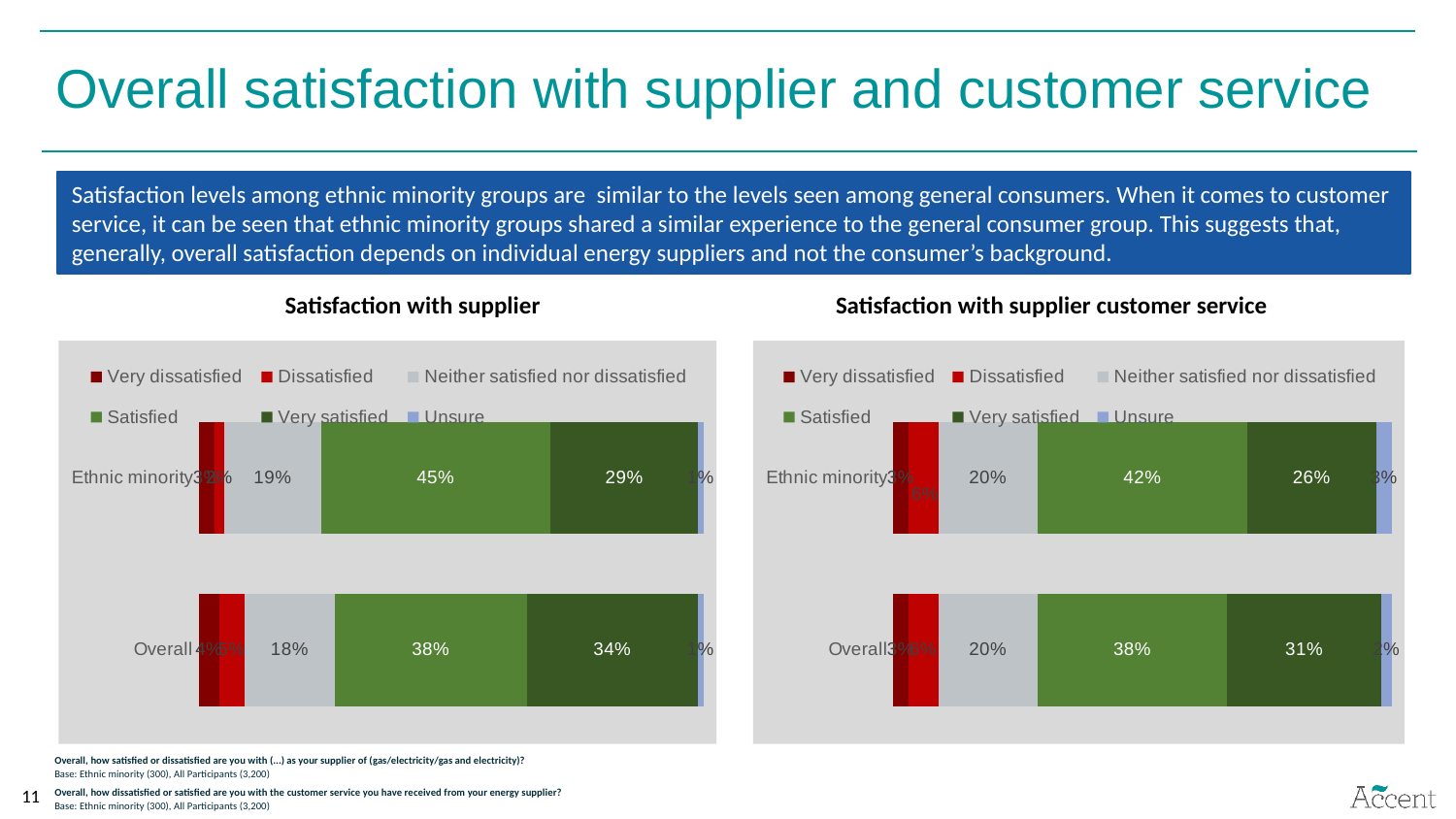
In the 'Satisfaction with supplier customer service' chart, what percentage of the Overall group is Very satisfied? 31% In the 'Satisfaction with supplier' chart, what is the difference between the Satisfied percentages for Ethnic minority and Overall? 7% What type of chart is the 'Satisfaction with supplier' chart? Stacked bar chart In the 'Satisfaction with supplier customer service' chart, which group has the larger Very satisfied percentage, Ethnic minority or Overall? Overall In the 'Satisfaction with supplier customer service' chart, what percentage of the Ethnic minority group is Neither satisfied nor dissatisfied? 20% In the 'Satisfaction with supplier' chart, what percentage of the Overall group is Neither satisfied nor dissatisfied? 18% In the 'Satisfaction with supplier' chart, what percentage of the Overall group is Very satisfied? 34% How many groups (categories) are shown in the 'Satisfaction with supplier' chart? 2 In the 'Satisfaction with supplier' chart, which group has the larger Satisfied percentage, Ethnic minority or Overall? Ethnic minority In the 'Satisfaction with supplier customer service' chart, what percentage of the Ethnic minority group is Satisfied? 42% In the 'Satisfaction with supplier' chart, what percentage of the Ethnic minority group is Satisfied? 45% How many series does the legend of the 'Satisfaction with supplier customer service' chart list? 6